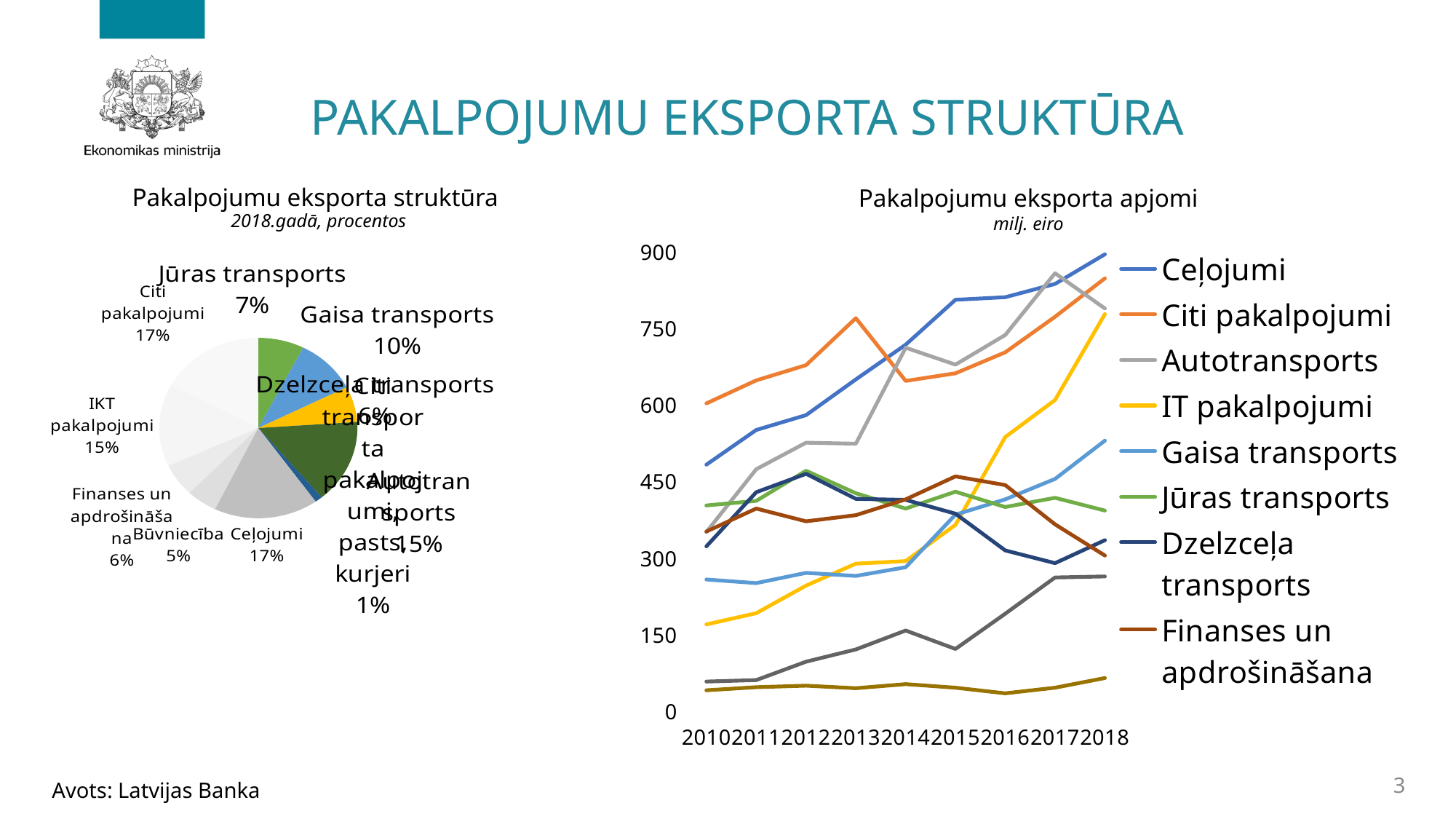
On the line chart 'Pakalpojumu eksporta apjomi', is the value for Ceļojumi in 2018 greater or less than 750? greater On the line chart 'Pakalpojumu eksporta apjomi', is the value for Gaisa transports in 2010 greater or less than 300? less On the pie chart 'Pakalpojumu eksporta struktūra', which category has the smallest share? Citi transporta pakalpojumi, pasts, kurjeri What type of chart is the left chart 'Pakalpojumu eksporta struktūra'? Pie chart On the line chart 'Pakalpojumu eksporta apjomi', how many years are shown on the x axis? 9 On the pie chart 'Pakalpojumu eksporta struktūra', which is larger: Gaisa transports or Jūras transports? Gaisa transports On the pie chart 'Pakalpojumu eksporta struktūra', what share does Gaisa transports have? 10% On the pie chart 'Pakalpojumu eksporta struktūra', what is the difference in percentage points between Autotransports and Būvniecība? 10 percentage points On the pie chart 'Pakalpojumu eksporta struktūra', what share does IKT pakalpojumi have? 15% On the line chart 'Pakalpojumu eksporta apjomi', does the Ceļojumi series rise or fall overall from 2010 to 2018? Rises On the line chart 'Pakalpojumu eksporta apjomi', how many series does the legend list? 8 What type of chart is the right chart 'Pakalpojumu eksporta apjomi'? Line chart